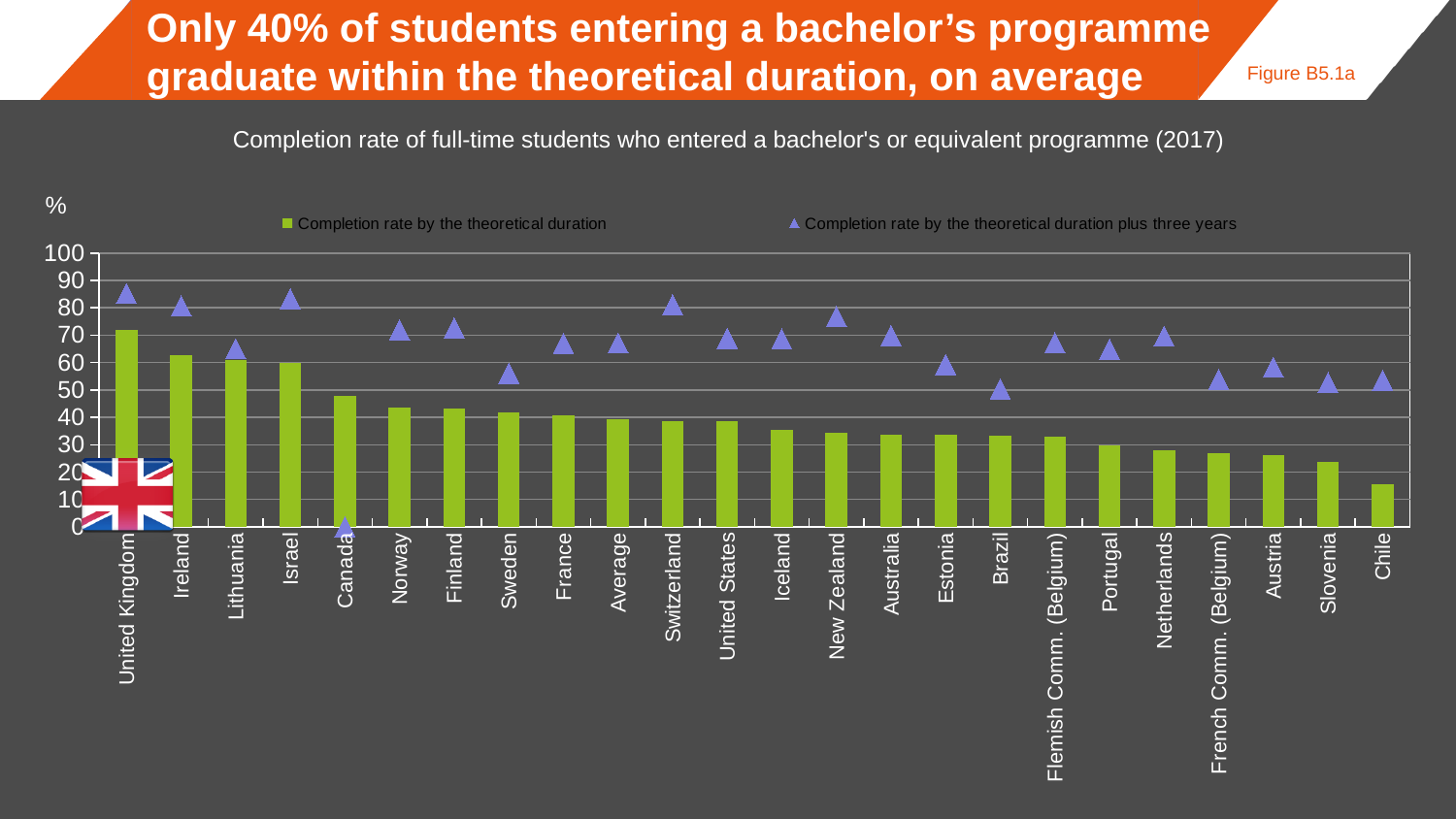
How many series does the chart legend list? 2 Is the completion rate by the theoretical duration plus three years for Brazil greater or less than 60? less What kind of chart is used to show the completion rate by the theoretical duration? bar chart How many countries or categories are shown on the x axis of the chart? 24 Which has a higher completion rate by the theoretical duration, Sweden or Austria? Sweden What is the subtitle describing the data shown in the chart? Completion rate of full-time students who entered a bachelor's or equivalent programme (2017) Is the completion rate by the theoretical duration for the United Kingdom greater or less than 60? greater Which category has the highest completion rate by the theoretical duration (tallest green bar)? United Kingdom Is the completion rate by the theoretical duration for Chile greater or less than 20? less Which category has the lowest completion rate by the theoretical duration (shortest green bar)? Chile Do the green bars (completion rate by the theoretical duration) generally rise or fall from left to right across the x axis? fall